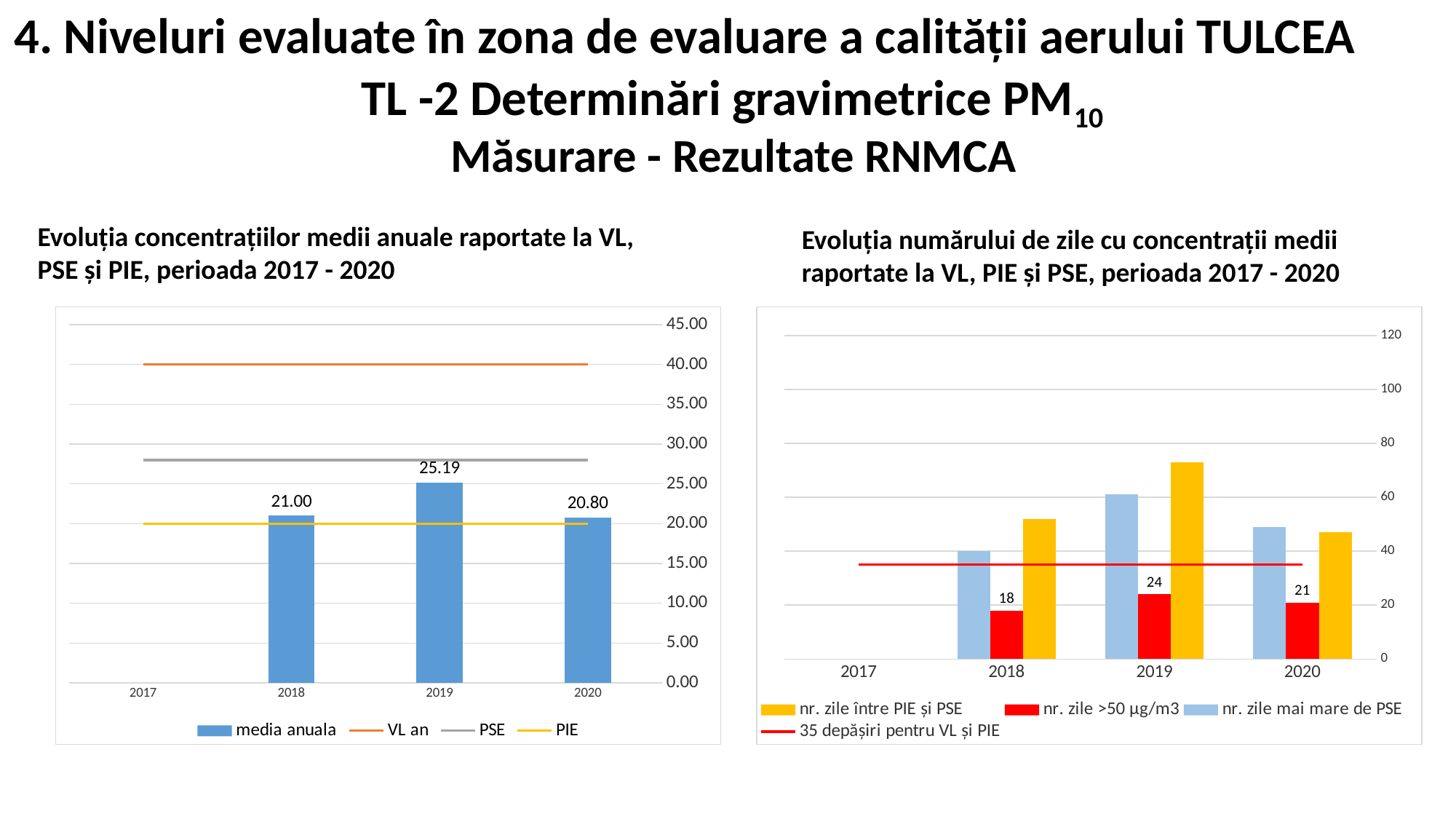
In the right chart (Evoluția numărului de zile), which year has the lowest nr. zile >50 µg/m3? 2018 In the left chart (Evoluția concentrațiilor medii anuale), what is the difference between the media anuala for 2019 and 2018? 4.19 In the right chart (Evoluția numărului de zile), which is larger: nr. zile mai mare de PSE for 2019 or for 2018? 2019 In the left chart (Evoluția concentrațiilor medii anuale), how many entries does the legend list? 4 In the left chart (Evoluția concentrațiilor medii anuale), what is the value of media anuala for 2019? 25.19 What type of chart is the right chart (Evoluția numărului de zile)? combination bar and line chart In the left chart (Evoluția concentrațiilor medii anuale), is the VL an line greater or less than 35.00? greater In the right chart (Evoluția numărului de zile), is the value of nr. zile între PIE și PSE for 2019 greater or less than 60? greater In the right chart (Evoluția numărului de zile), what is the value of nr. zile >50 µg/m3 for 2018? 18 In the left chart (Evoluția concentrațiilor medii anuale), which year has the highest media anuala? 2019 In the left chart (Evoluția concentrațiilor medii anuale), what is the value of media anuala for 2020? 20.80 In the right chart (Evoluția numărului de zile), what is the value of nr. zile >50 µg/m3 for 2019? 24